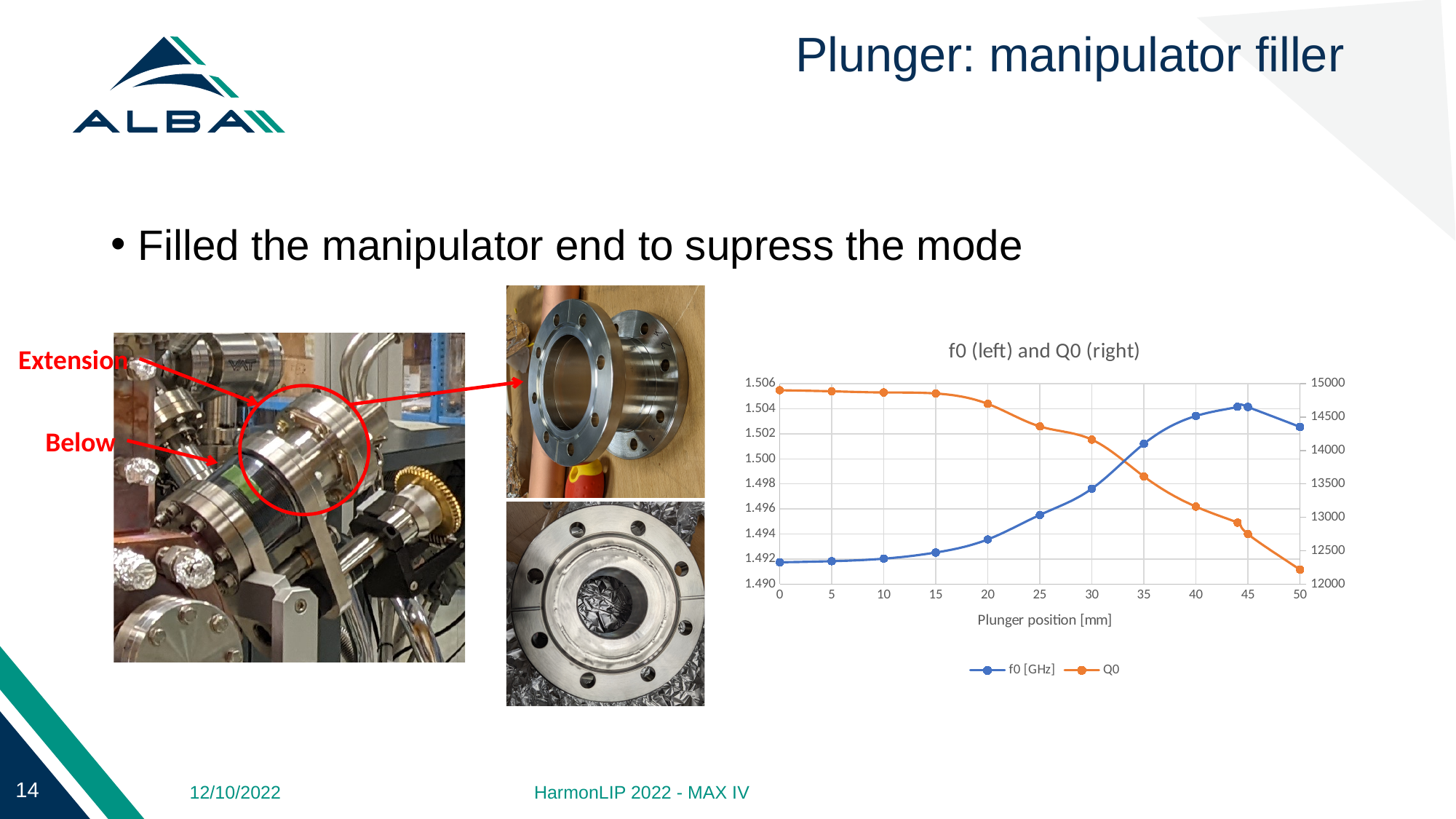
Is the Q0 value at plunger position 50 mm greater or less than 12500? less Which is larger, the f0 [GHz] value at 35 mm or at 20 mm? 35 mm Is the Q0 value at plunger position 0 mm greater or less than 14500? greater What is the x-axis label of the chart? Plunger position [mm] At which plunger position is the Q0 value lowest? 50 Does the Q0 series rise or fall as the plunger position increases from 0 to 50 mm? fall What is the title of the chart? f0 (left) and Q0 (right) Is the Q0 value at plunger position 40 mm greater or less than 13500? less How many series does the chart legend list? 2 What kind of chart is shown on the slide? line chart